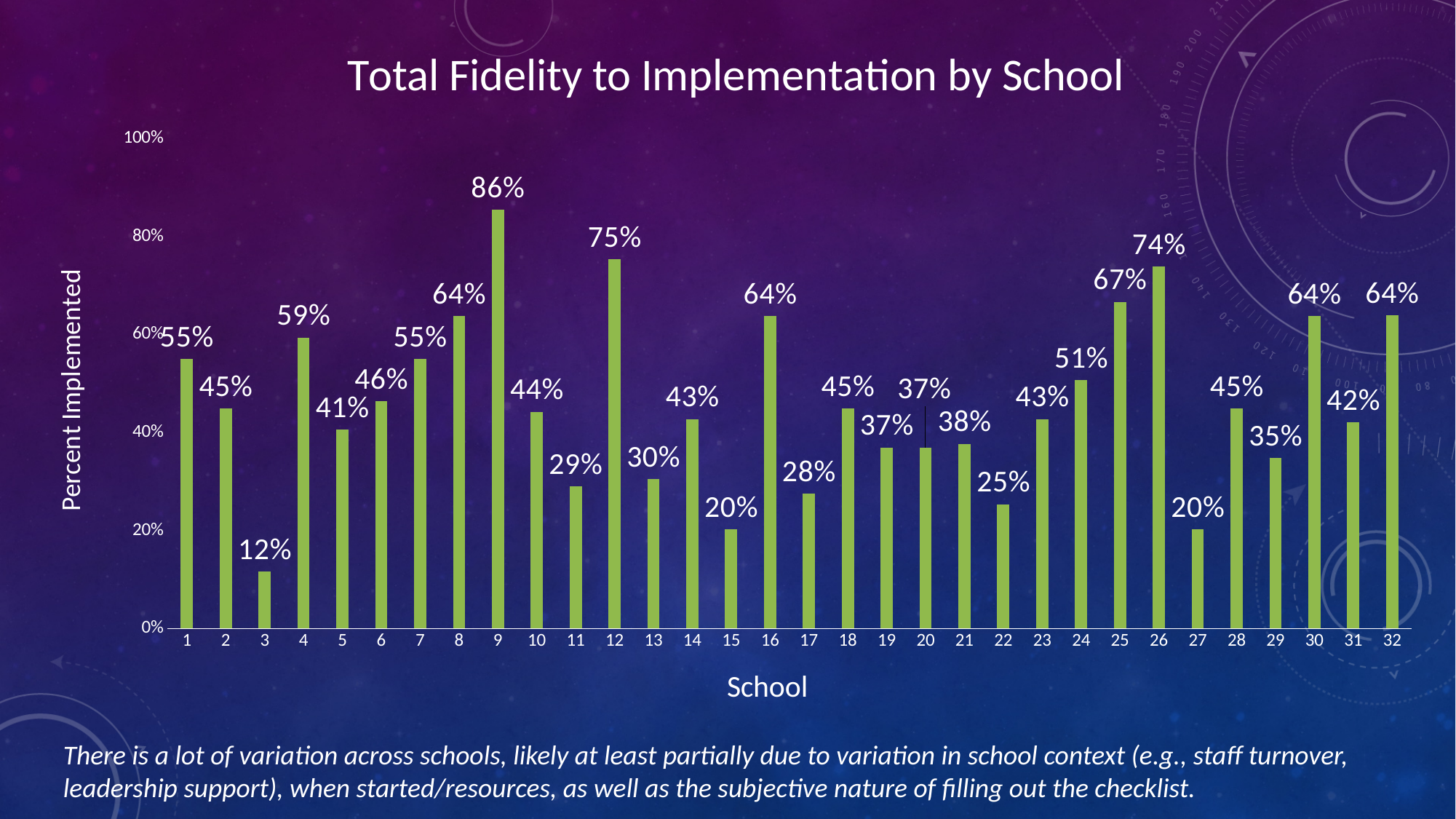
Which school has the lowest percent implemented? 3 What kind of chart is shown on the slide? Bar chart Which school has the highest percent implemented? 9 Which has a higher percent implemented, school 4 or school 5? School 4 What is the percent implemented for school 3? 12% What is the difference in percent implemented between school 26 and school 27? 54% What is the difference in percent implemented between school 9 and school 12? 11% How many schools are shown on the chart? 32 What is the title of the chart? Total Fidelity to Implementation by School Which has a higher percent implemented, school 16 or school 17? School 16 What is the percent implemented for school 9? 86% What is the percent implemented for school 25? 67%